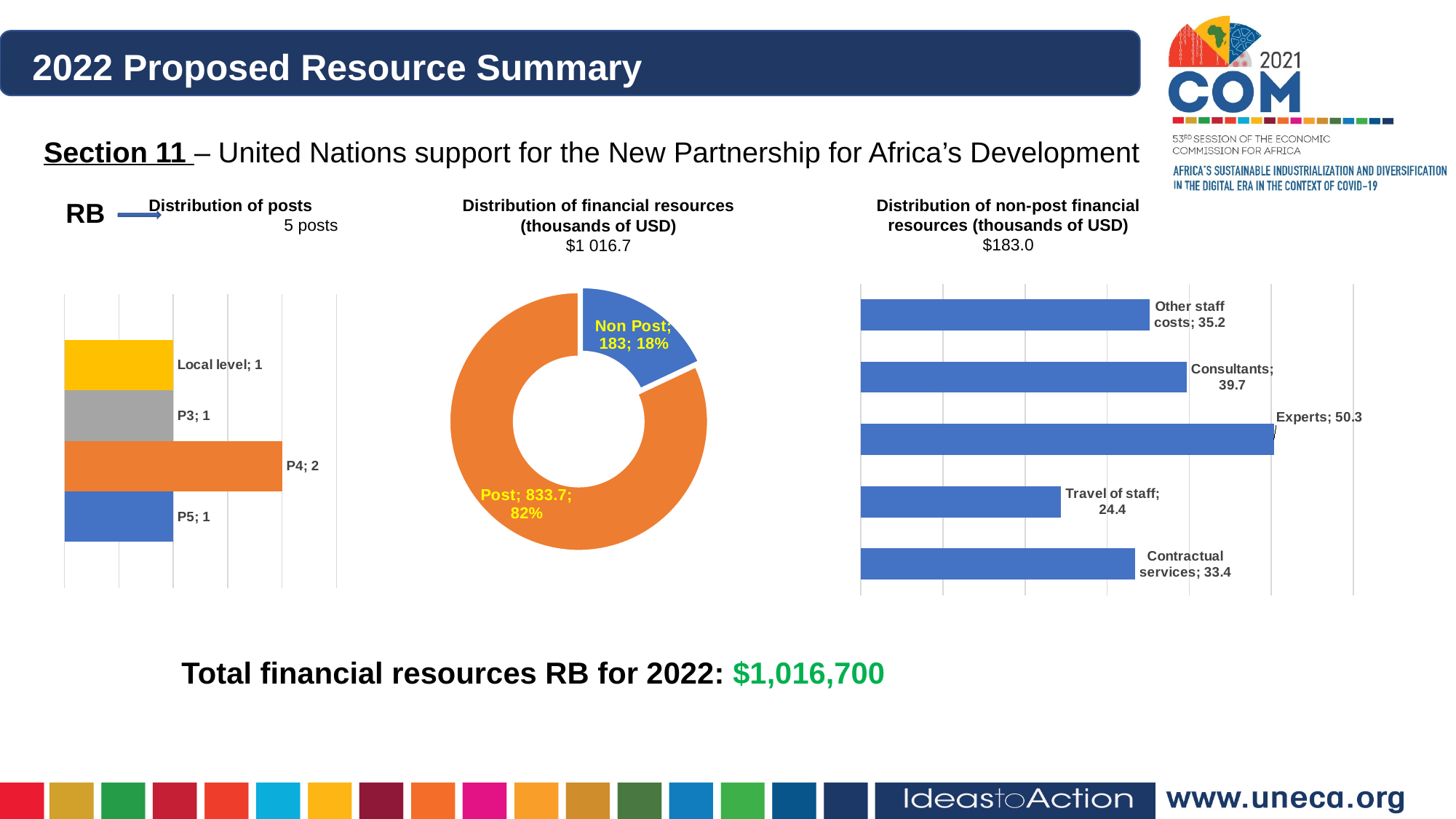
What kind of chart is the 'Distribution of posts' chart? Bar chart What kind of chart is the 'Distribution of financial resources' chart? Doughnut chart In the 'Distribution of non-post financial resources' chart, which is larger: Other staff costs or Consultants? Consultants In the 'Distribution of non-post financial resources' chart, which category has the lowest value? Travel of staff In the 'Distribution of posts' chart, which category has the highest number of posts? P4 In the 'Distribution of non-post financial resources' chart, which category has the highest value? Experts In the 'Distribution of non-post financial resources' chart, what is the difference between Experts and Contractual services? 16.9 How many categories are shown in the 'Distribution of posts' chart? 4 In the 'Distribution of financial resources' chart, what share does Non Post represent? 18% In the 'Distribution of financial resources' chart, what is the value for Post? 833.7 In the 'Distribution of posts' chart, how many posts are at the P4 level? 2 In the 'Distribution of non-post financial resources' chart, what is the value for Consultants? 39.7